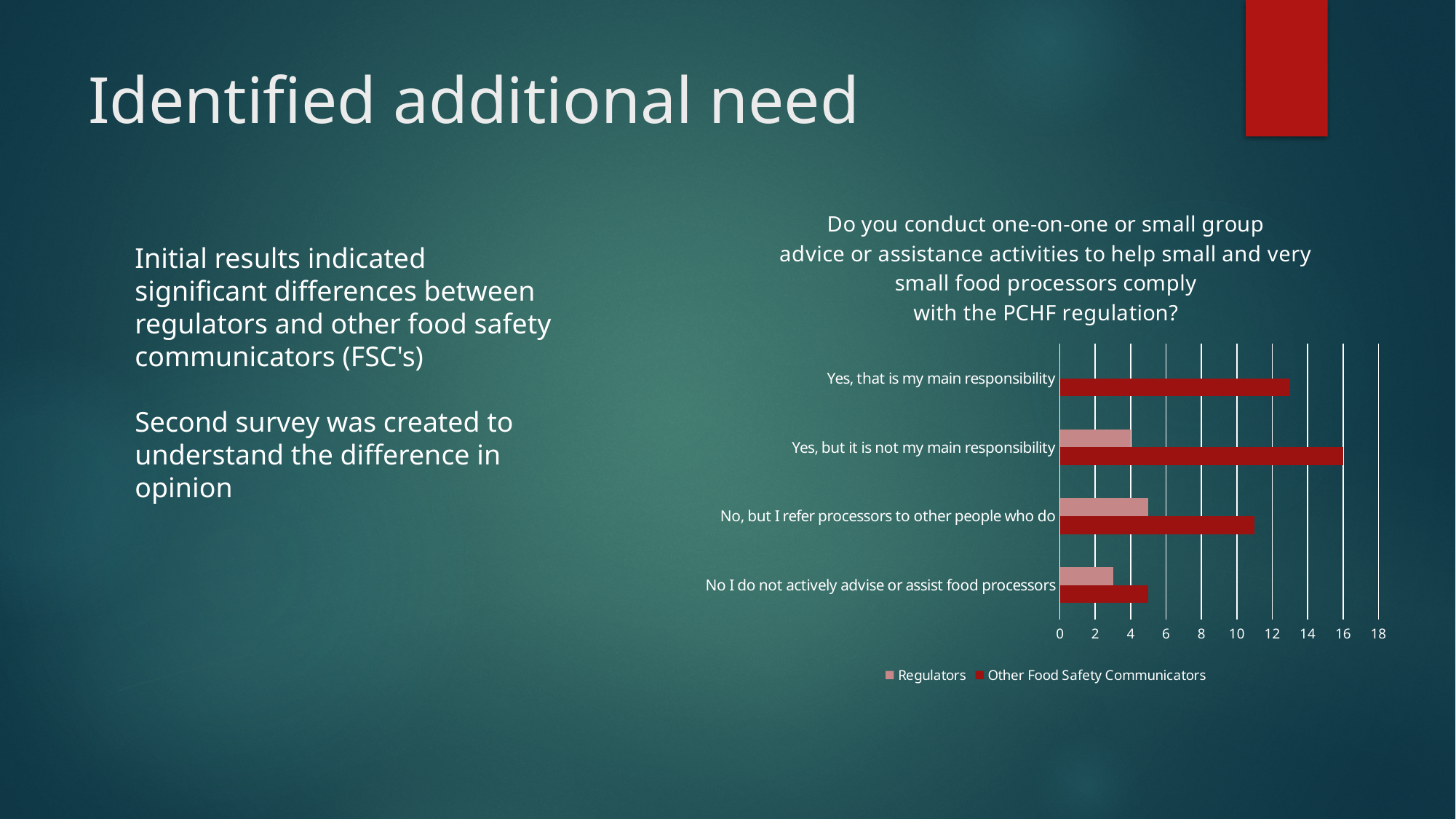
Is the value for Other Food Safety Communicators for 'No, but I refer processors to other people who do' greater or less than 12? less Is the value for Other Food Safety Communicators for 'Yes, that is my main responsibility' greater or less than 12? greater Which response category has the lowest value for Other Food Safety Communicators? No I do not actively advise or assist food processors For 'No, but I refer processors to other people who do', which series has the larger value, Regulators or Other Food Safety Communicators? Other Food Safety Communicators How many response categories are shown on the chart? 4 Which series is shown in dark red in the chart? Other Food Safety Communicators Which response category has the highest value for Regulators? No, but I refer processors to other people who do Is the value for Regulators for 'No I do not actively advise or assist food processors' greater or less than 4? less Which response category has the highest value for Other Food Safety Communicators? Yes, but it is not my main responsibility What is the highest value shown on the chart's horizontal axis? 18 What kind of chart is shown on the slide? bar chart How many series does the chart legend list? 2